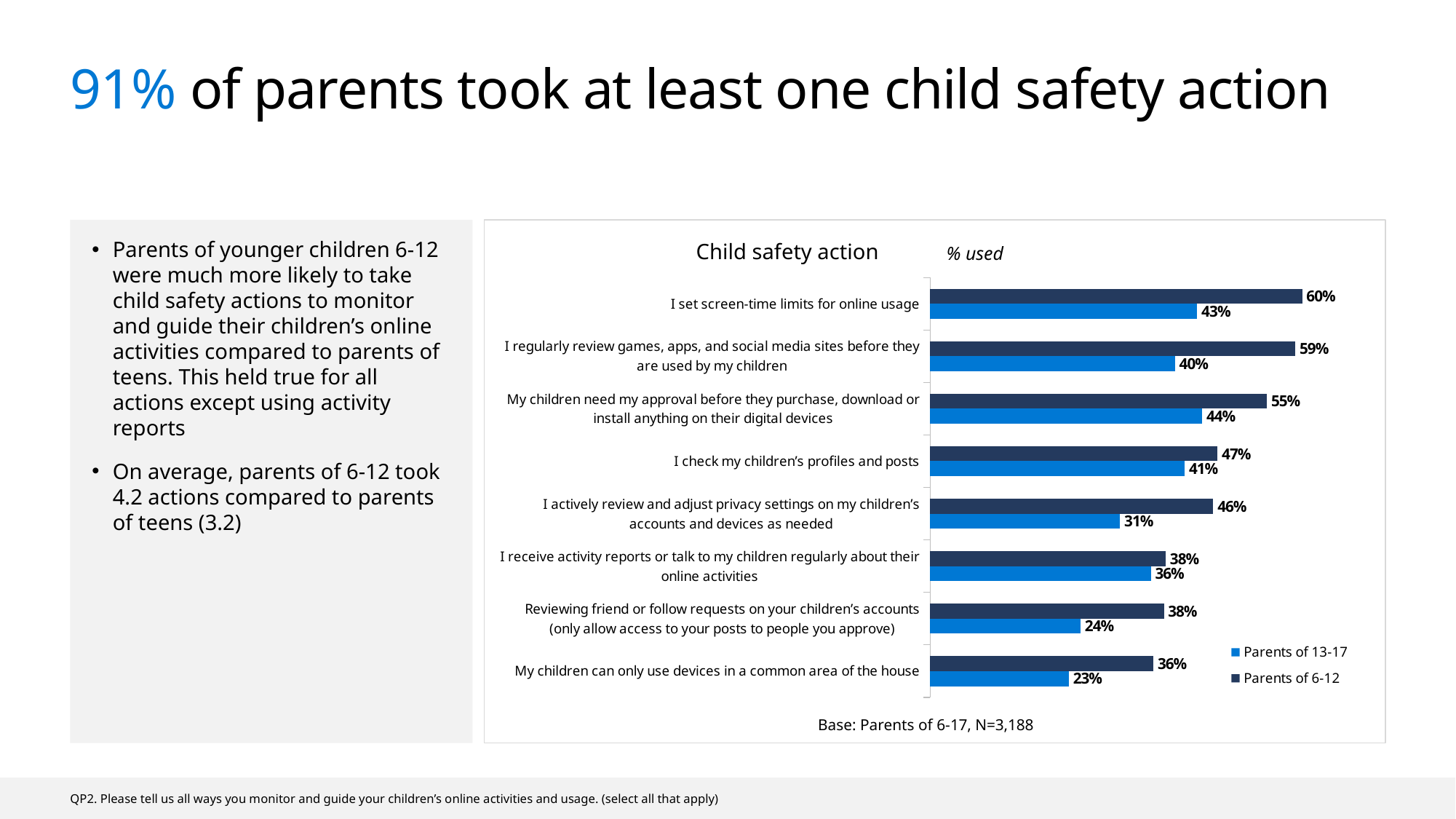
What type of chart is shown on the slide? Bar chart Which child safety action has the lowest value for Parents of 13-17? My children can only use devices in a common area of the house For regularly reviewing games, apps, and social media sites, which group has the larger value: Parents of 6-12 or Parents of 13-17? Parents of 6-12 Which child safety action has the highest value for Parents of 6-12? I set screen-time limits for online usage What percentage of Parents of 13-17 actively review and adjust privacy settings on their children's accounts and devices? 31% What percentage of Parents of 6-12 set screen-time limits for online usage? 60% What is the title of the chart? Child safety action How many child safety actions are listed in the chart? 8 What percentage of Parents of 13-17 say their children can only use devices in a common area of the house? 23% What is the base stated below the chart? Parents of 6-17, N=3,188 How many series does the chart legend list? 2 What is the difference between Parents of 6-12 and Parents of 13-17 for reviewing friend or follow requests on children's accounts? 14 percentage points